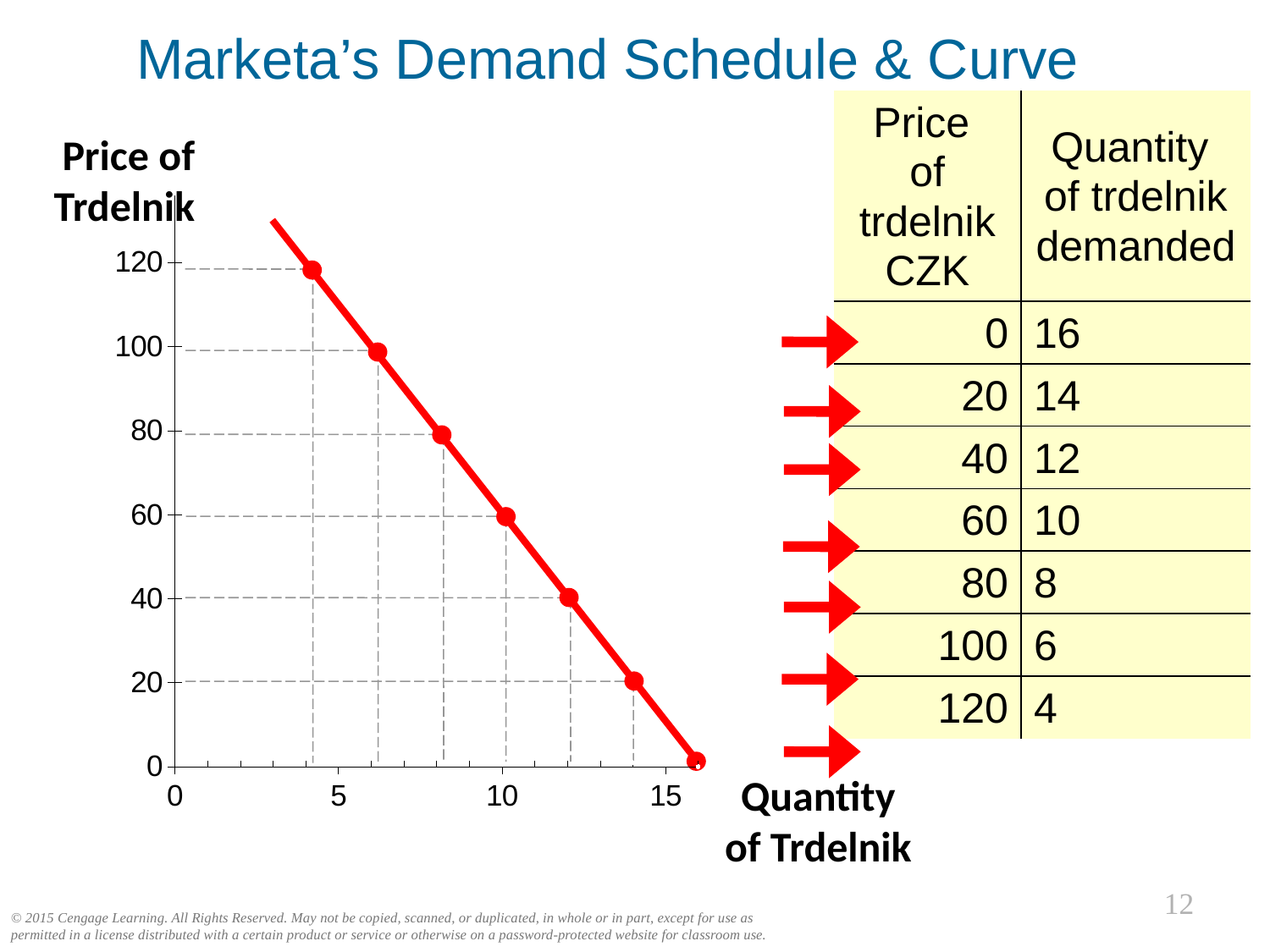
As quantity increases along the x axis, does the price on the demand curve rise or fall? fall At which price in the table is the quantity demanded the lowest? 120 At which price in the table is the quantity demanded the highest? 0 What is the label of the vertical axis of the chart? Price of Trdelnik What is the difference between the quantity demanded at a price of 20 CZK and at a price of 100 CZK? 8 What type of chart is shown on the slide? line chart According to the table, what quantity of trdelnik is demanded when the price is 0 CZK? 16 According to the table, what quantity of trdelnik is demanded when the price is 120 CZK? 4 Is the quantity demanded larger at a price of 40 CZK or at a price of 80 CZK? 40 CZK How many data points are plotted on the demand curve? 7 What is the title of the slide containing the chart? Marketa's Demand Schedule & Curve According to the table, what quantity of trdelnik is demanded when the price is 60 CZK? 10